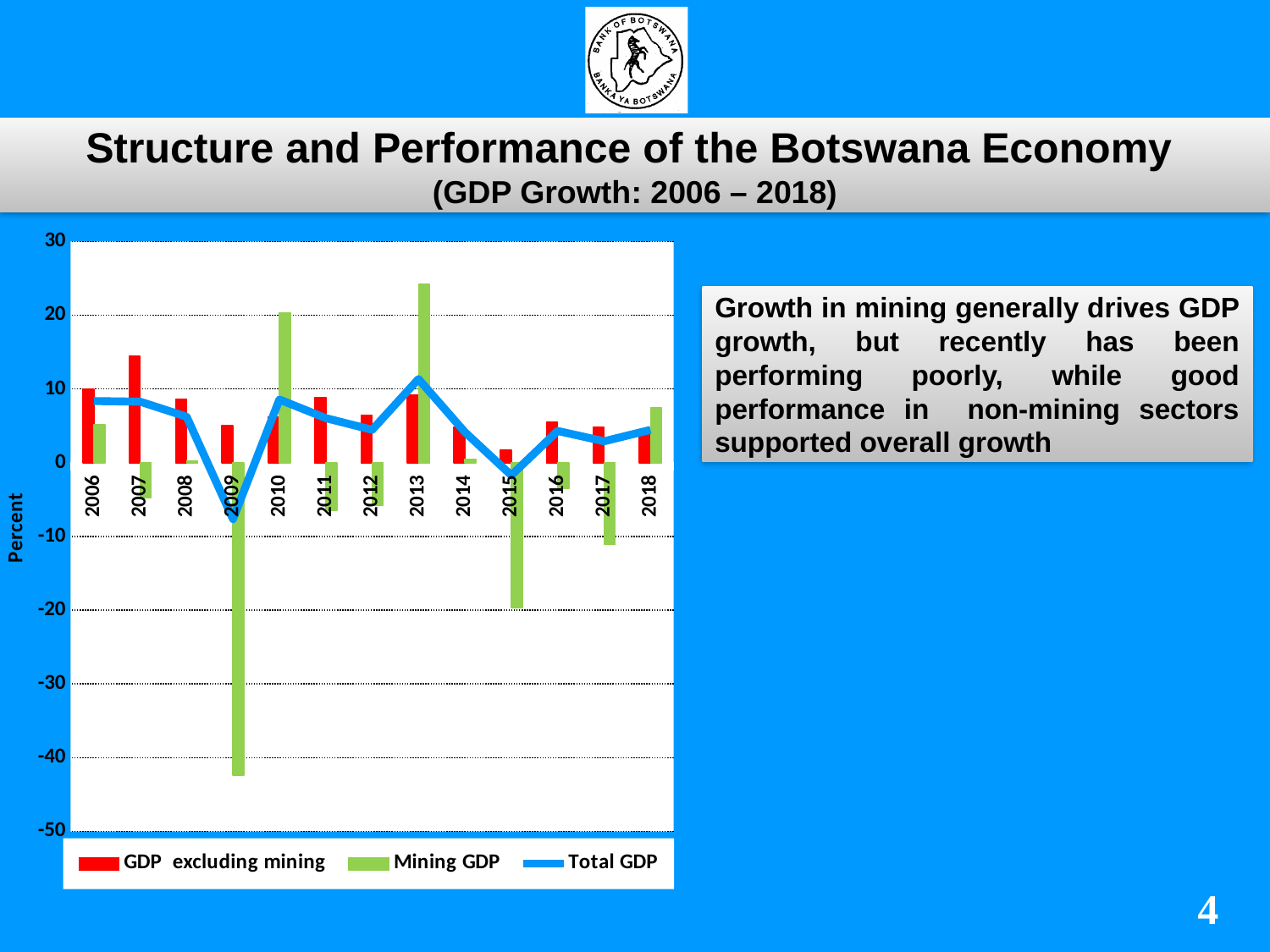
Is the Total GDP value for 2009 greater or less than 0? less Is the Mining GDP value for 2009 greater or less than -30? less Which is larger, GDP excluding mining growth in 2007 or in 2008? 2007 In which year is GDP excluding mining growth highest? 2007 Does Total GDP growth rise or fall from 2013 to 2015? fall Is the Mining GDP value for 2013 greater or less than 20? greater In which year is Mining GDP growth highest? 2013 In which year is Mining GDP growth lowest? 2009 How many series does the chart legend list? 3 What kind of chart is shown on the slide? Combined bar and line chart How many years are shown on the x axis of the chart? 13